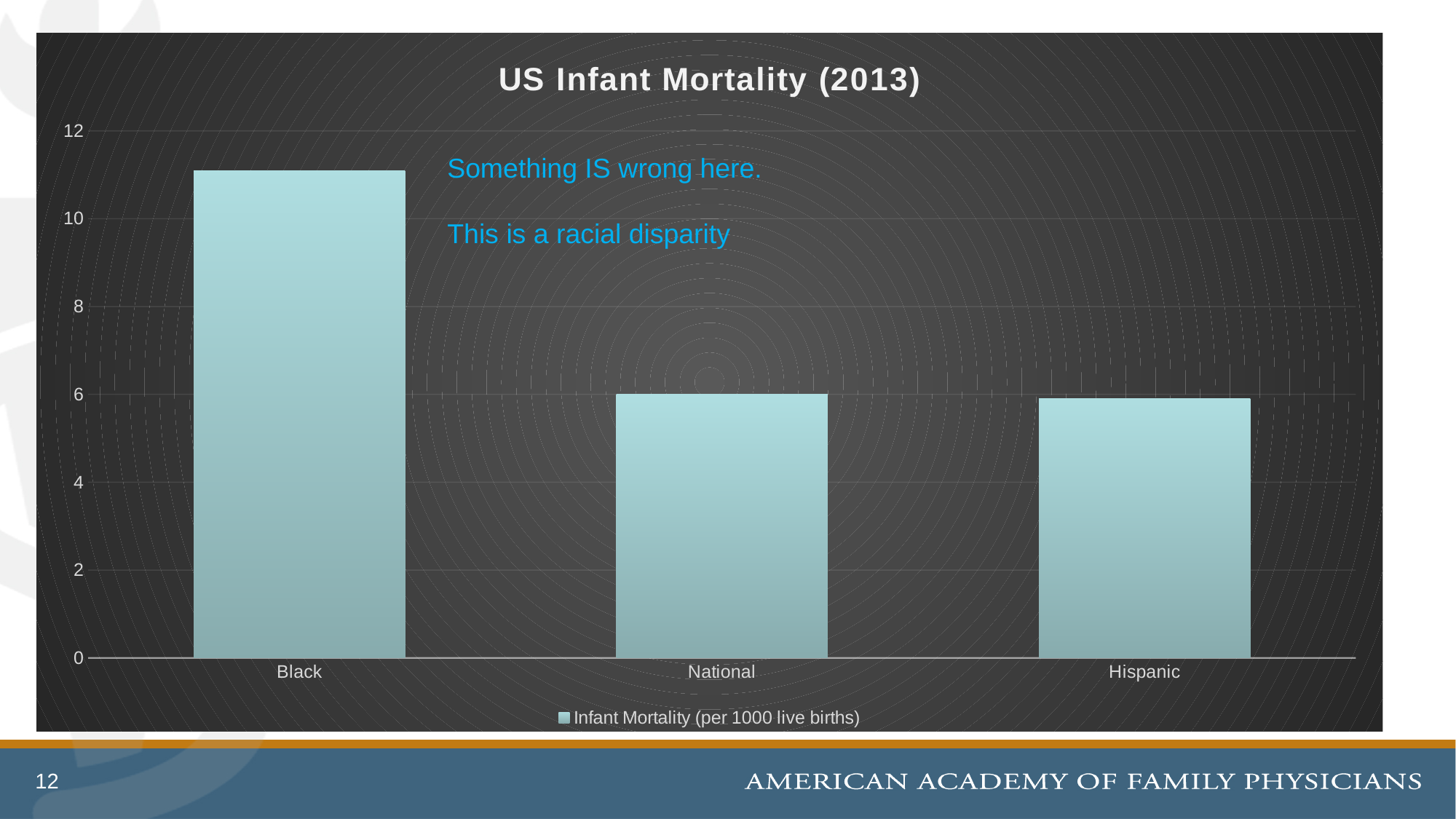
Is the value for National greater or less than 8? less Is the value for Hispanic greater or less than 8? less How many categories are shown on the x axis of the chart? 3 How many series does the chart's legend list? 1 What is the series name shown in the chart's legend? Infant Mortality (per 1000 live births) Is the value for Black greater or less than 10? greater Which category has the highest infant mortality in the chart? Black Which is larger, the value for Black or the value for National? Black What is the title of the chart? US Infant Mortality (2013) What is the infant mortality value for National? 6 Which is larger, the value for Hispanic or the value for Black? Black What kind of chart is shown on the slide? bar chart